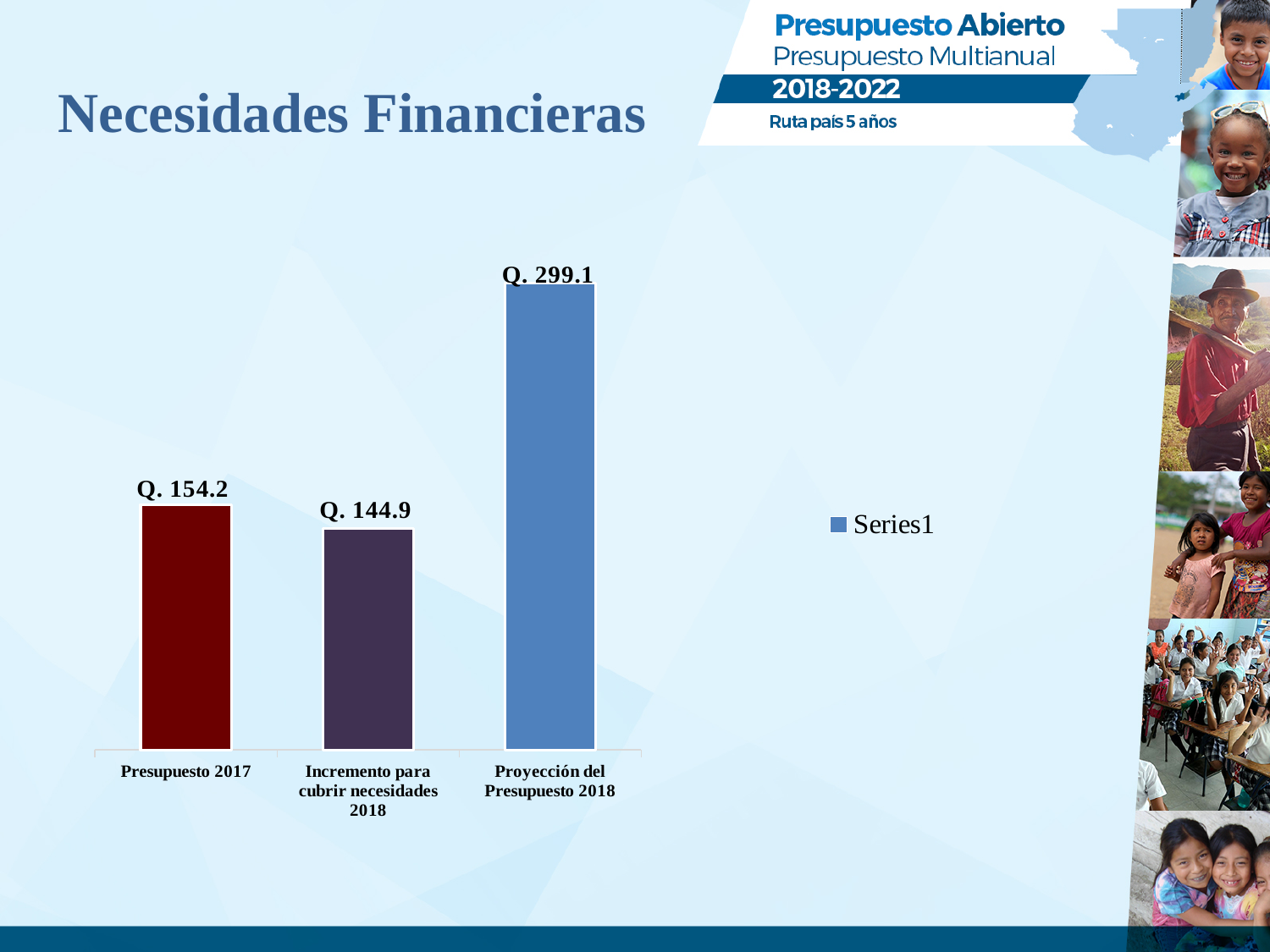
What is the difference between Proyección del Presupuesto 2018 and Presupuesto 2017? Q. 144.9 How many series does the legend list? 1 What is the value for Presupuesto 2017? Q. 154.2 What is the value for Incremento para cubrir necesidades 2018? Q. 144.9 What kind of chart is shown on the slide? Bar chart What is the difference between Presupuesto 2017 and Incremento para cubrir necesidades 2018? Q. 9.3 What is the value for Proyección del Presupuesto 2018? Q. 299.1 Which category has the lowest value? Incremento para cubrir necesidades 2018 Which is larger, Presupuesto 2017 or Proyección del Presupuesto 2018? Proyección del Presupuesto 2018 Which category has the highest value? Proyección del Presupuesto 2018 What is the title of the slide containing the chart? Necesidades Financieras How many categories are shown in the chart? 3